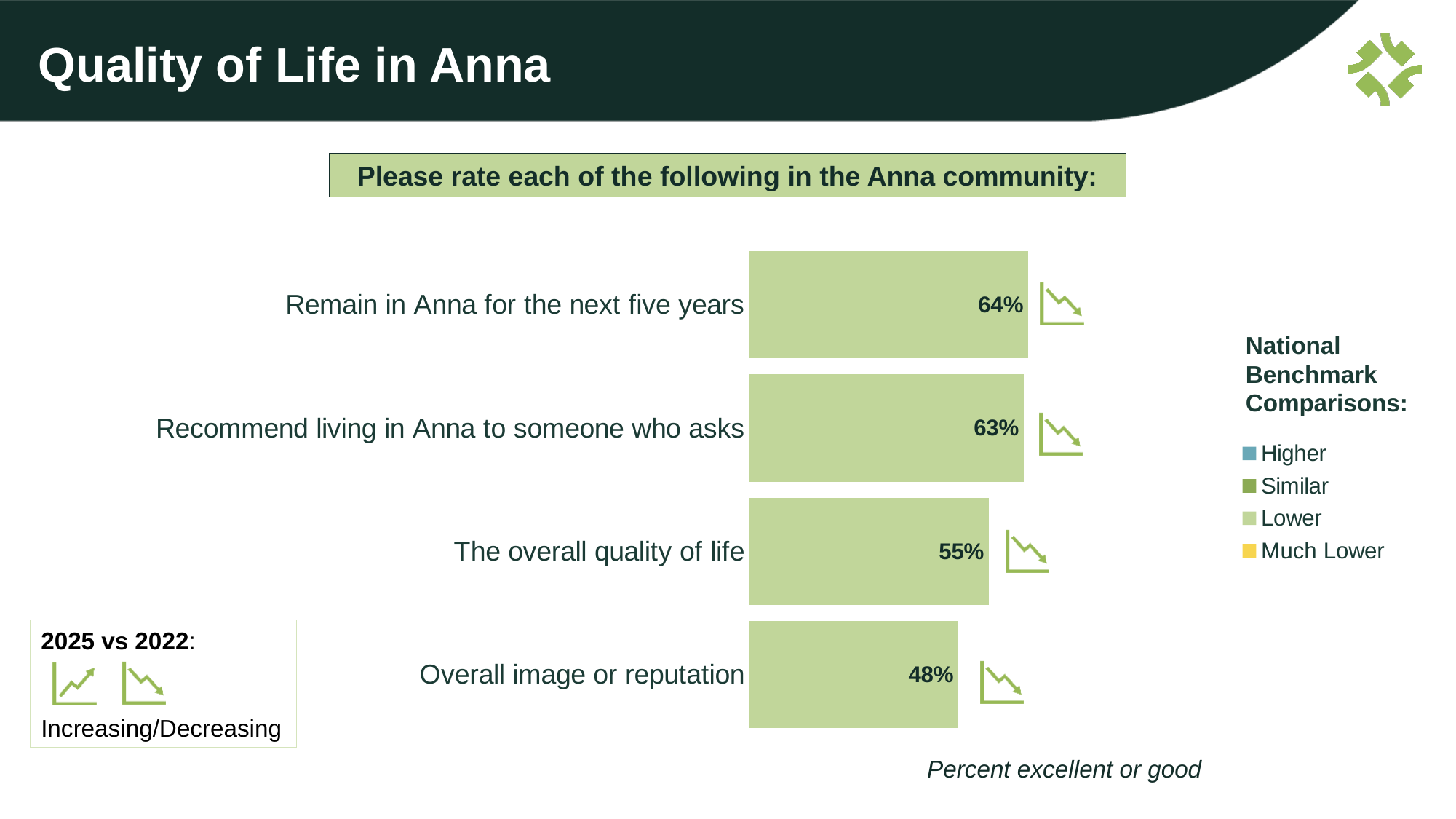
How many items are rated in the chart? 4 Which item has the highest percentage rated excellent or good? Remain in Anna for the next five years What is the difference in percentage points between 'The overall quality of life' and 'Overall image or reputation'? 7 What is the value for 'Recommend living in Anna to someone who asks'? 63% How many categories does the National Benchmark Comparisons legend list? 4 What percentage of respondents rated 'Remain in Anna for the next five years' as excellent or good? 64% Which item has the lowest percentage rated excellent or good? Overall image or reputation What is the value for 'The overall quality of life'? 55% What is the difference in percentage points between 'Remain in Anna for the next five years' and 'Overall image or reputation'? 16 What is the value for 'Overall image or reputation'? 48% Which is larger: the value for 'The overall quality of life' or for 'Overall image or reputation'? The overall quality of life What kind of chart is shown on the slide? Bar chart